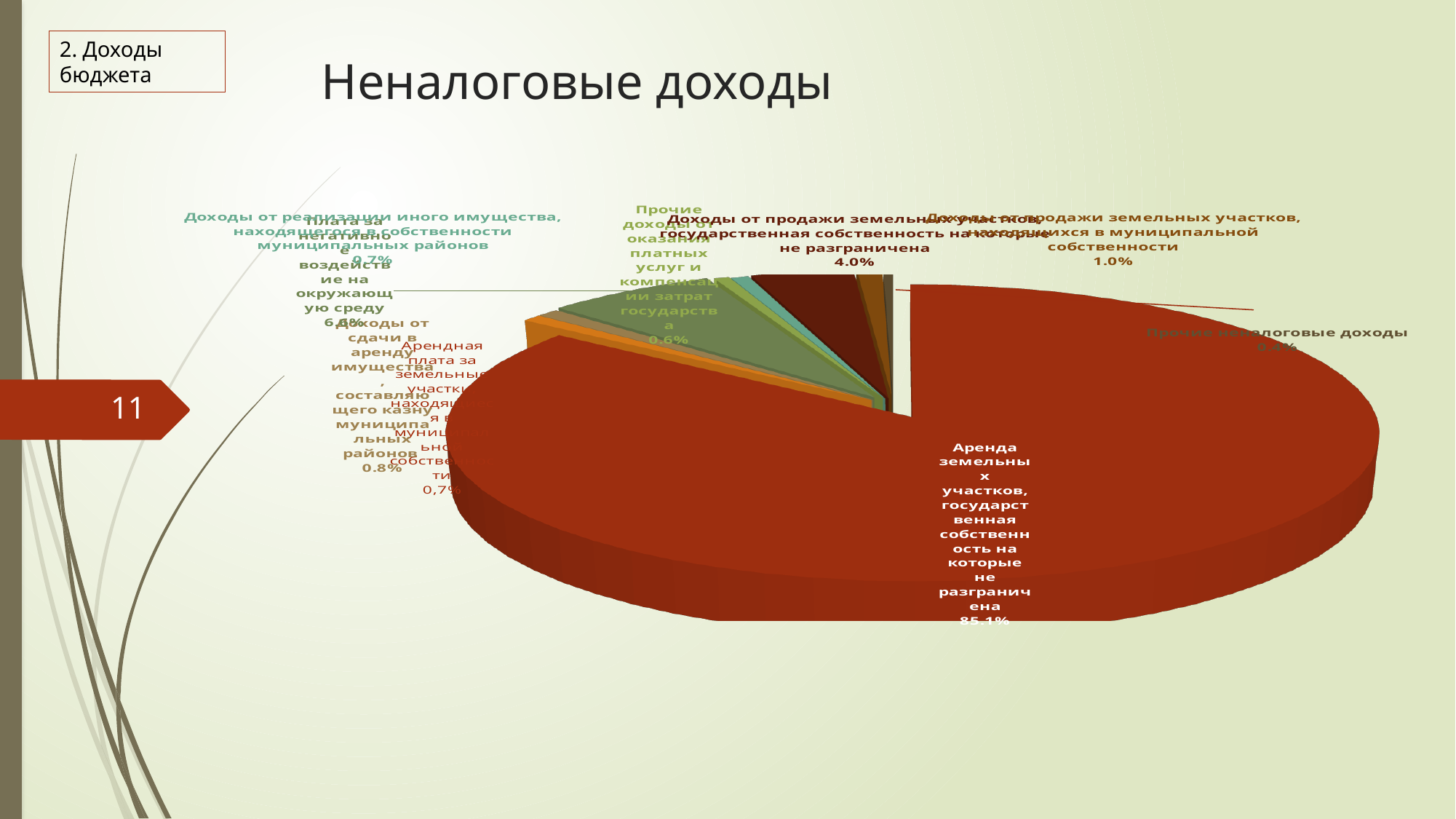
What colour is the largest slice of the pie? red What value is shown for 'Прочие доходы от оказания платных услуг и компенсации затрат государства'? 0.6% Which is larger: 'Доходы от продажи земельных участков, государственная собственность на которые не разграничена' or 'Прочие доходы от оказания платных услуг и компенсации затрат государства'? Доходы от продажи земельных участков, государственная собственность на которые не разграничена Which category has the largest slice of the pie? Аренда земельных участков, государственная собственность на которые не разграничена What kind of chart is shown on the slide? pie chart What share of the pie is 'Аренда земельных участков, государственная собственность на которые не разграничена'? 85.1% Which is larger: the share for sale of land plots with undelimited state ownership (государственная собственность не разграничена) or the share for sale of land plots in municipal ownership (в муниципальной собственности)? Доходы от продажи земельных участков, государственная собственность на которые не разграничена What is the difference between the largest slice (85.1%) and the 4.0% slice? 81.1% What is the title of the slide containing the pie chart? Неналоговые доходы What value is shown for 'Доходы от продажи земельных участков, находящихся в муниципальной собственности'? 1.0% What value is shown for 'Доходы от продажи земельных участков, государственная собственность на которые не разграничена'? 4.0% What is the difference between the 4.0% slice and the 1.0% slice? 3.0%